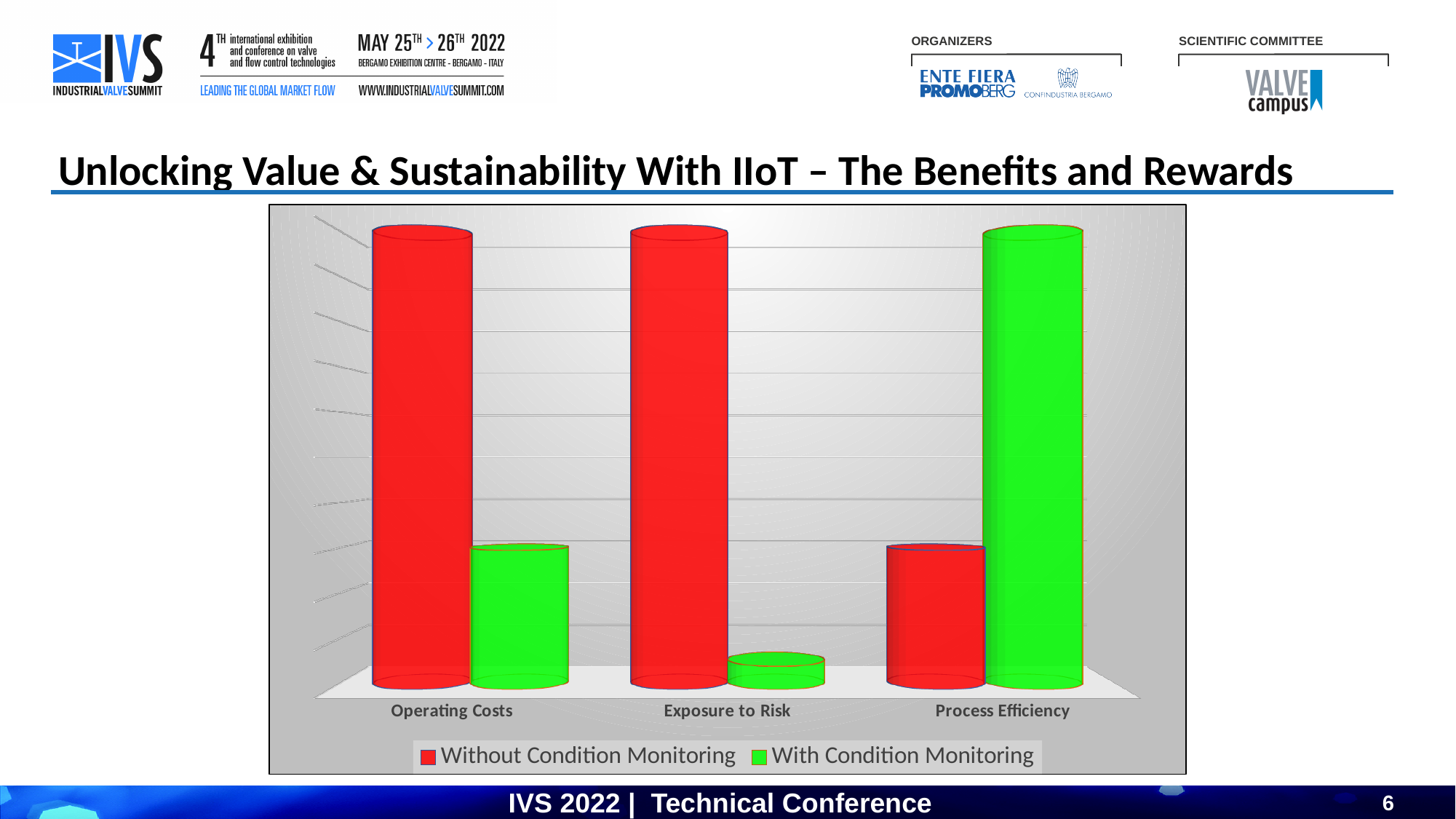
For Operating Costs, which is larger: Without Condition Monitoring or With Condition Monitoring? Without Condition Monitoring How many categories are shown on the x axis of the chart? 3 For Exposure to Risk, which is larger: Without Condition Monitoring or With Condition Monitoring? Without Condition Monitoring What kind of chart is shown on the slide? Bar chart Which category has the lowest value for the Without Condition Monitoring series? Process Efficiency Which colour represents the With Condition Monitoring series in the chart? Green For Process Efficiency, which is larger: Without Condition Monitoring or With Condition Monitoring? With Condition Monitoring What are the two series named in the chart's legend? Without Condition Monitoring and With Condition Monitoring Which category has the lowest value for the With Condition Monitoring series? Exposure to Risk Which category has the highest value for the With Condition Monitoring series? Process Efficiency How many series does the chart's legend list? 2